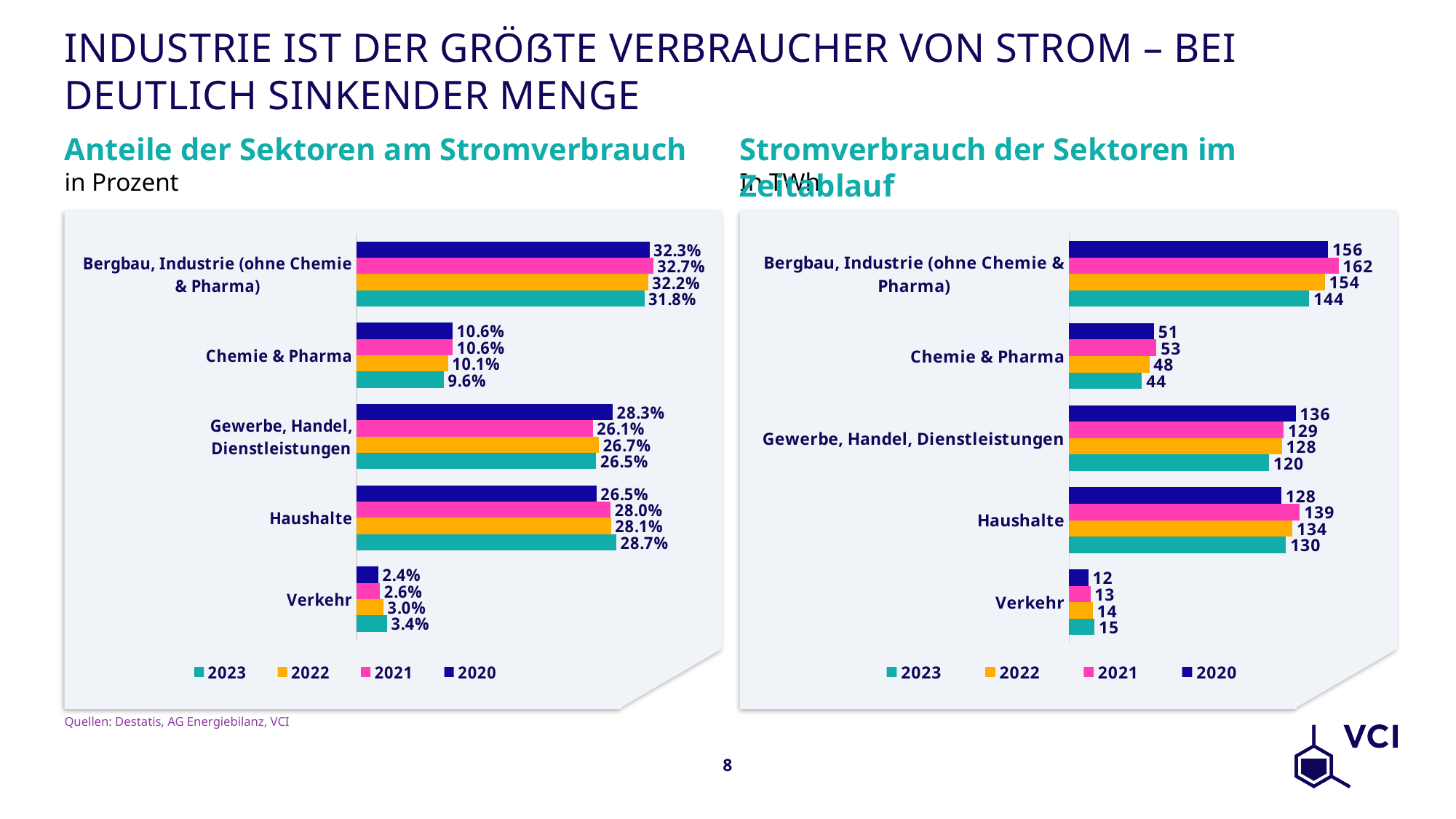
How many series does the legend of the left chart 'Anteile der Sektoren am Stromverbrauch' list? 4 How many categories are shown in the right chart 'Stromverbrauch der Sektoren im Zeitablauf'? 5 In the left chart 'Anteile der Sektoren am Stromverbrauch', which category has the lowest value in 2020? Verkehr In the left chart 'Anteile der Sektoren am Stromverbrauch', what is the difference between the 2020 and 2023 values for Verkehr? 1.0% In the left chart 'Anteile der Sektoren am Stromverbrauch', which is larger for 2023: Gewerbe, Handel, Dienstleistungen or Haushalte? Haushalte In the right chart 'Stromverbrauch der Sektoren im Zeitablauf', which category has the highest value in 2023? Bergbau, Industrie (ohne Chemie & Pharma) Which colour represents the year 2022 in the legends of both charts? Orange In the right chart 'Stromverbrauch der Sektoren im Zeitablauf', do the values for Chemie & Pharma rise or fall from 2021 to 2023? Fall In the left chart 'Anteile der Sektoren am Stromverbrauch', what is the value for Chemie & Pharma in 2023? 9.6% In the right chart 'Stromverbrauch der Sektoren im Zeitablauf', what is the value for Haushalte in 2021? 139 What kind of chart is the right chart 'Stromverbrauch der Sektoren im Zeitablauf'? Bar chart In the right chart 'Stromverbrauch der Sektoren im Zeitablauf', what is the difference between the 2021 and 2023 values for Bergbau, Industrie (ohne Chemie & Pharma)? 18